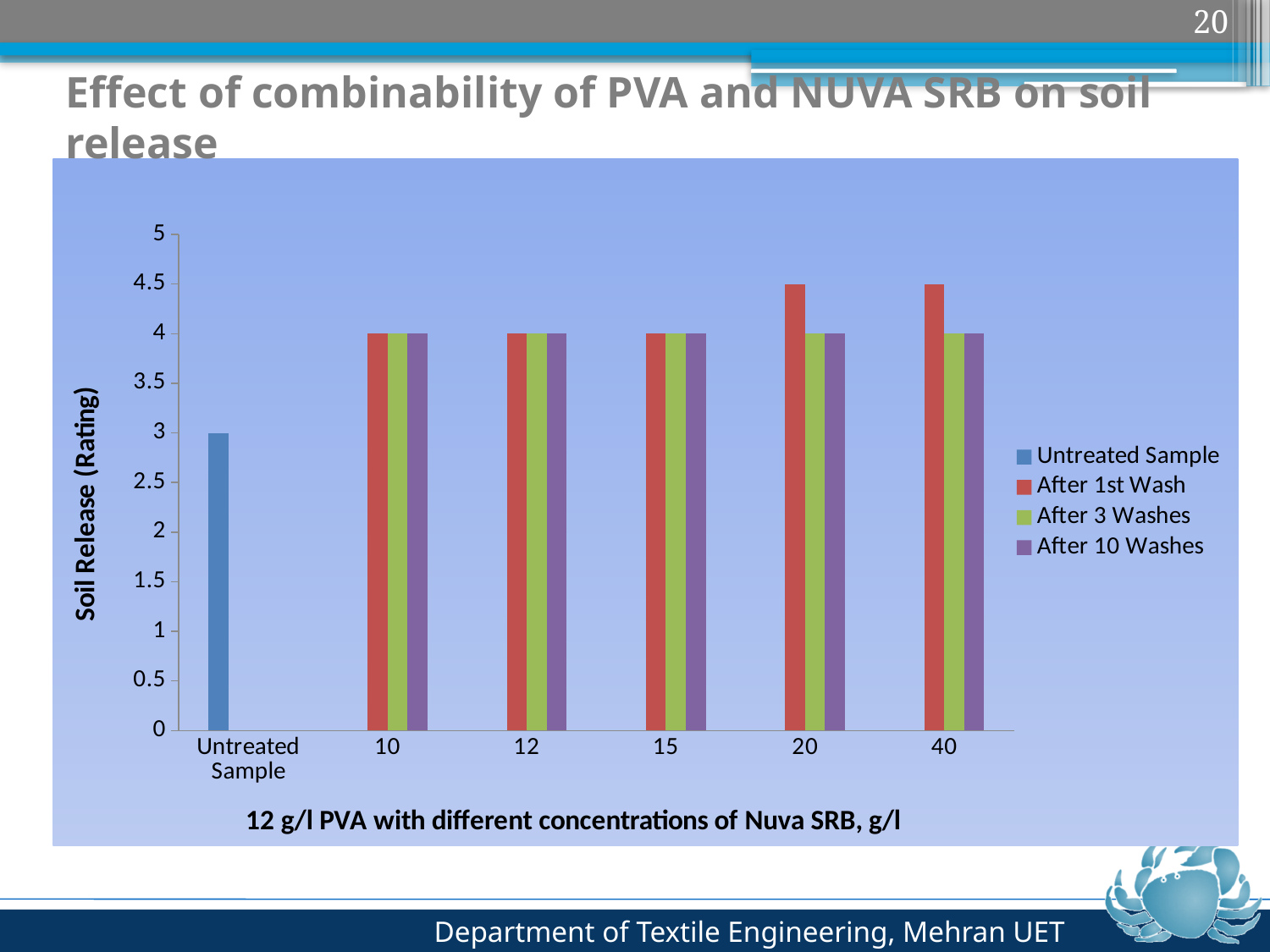
What is the After 10 Washes soil release rating at 40 g/l Nuva SRB? 4 Is the soil release rating for the Untreated Sample greater or less than 3.5? less What is the label of the y axis? Soil Release (Rating) How many series does the legend list? 4 Which colour represents the After 10 Washes series in the legend? purple What is the soil release rating for the Untreated Sample? 3 What is the difference between the After 1st Wash rating at 20 g/l and the Untreated Sample rating? 1.5 How many categories are shown on the x axis? 6 What kind of chart is shown on the slide? bar chart What is the After 3 Washes soil release rating at 12 g/l Nuva SRB? 4 What is the After 1st Wash soil release rating at 20 g/l Nuva SRB? 4.5 Which is larger: the After 1st Wash rating at 40 g/l or the After 3 Washes rating at 40 g/l? After 1st Wash